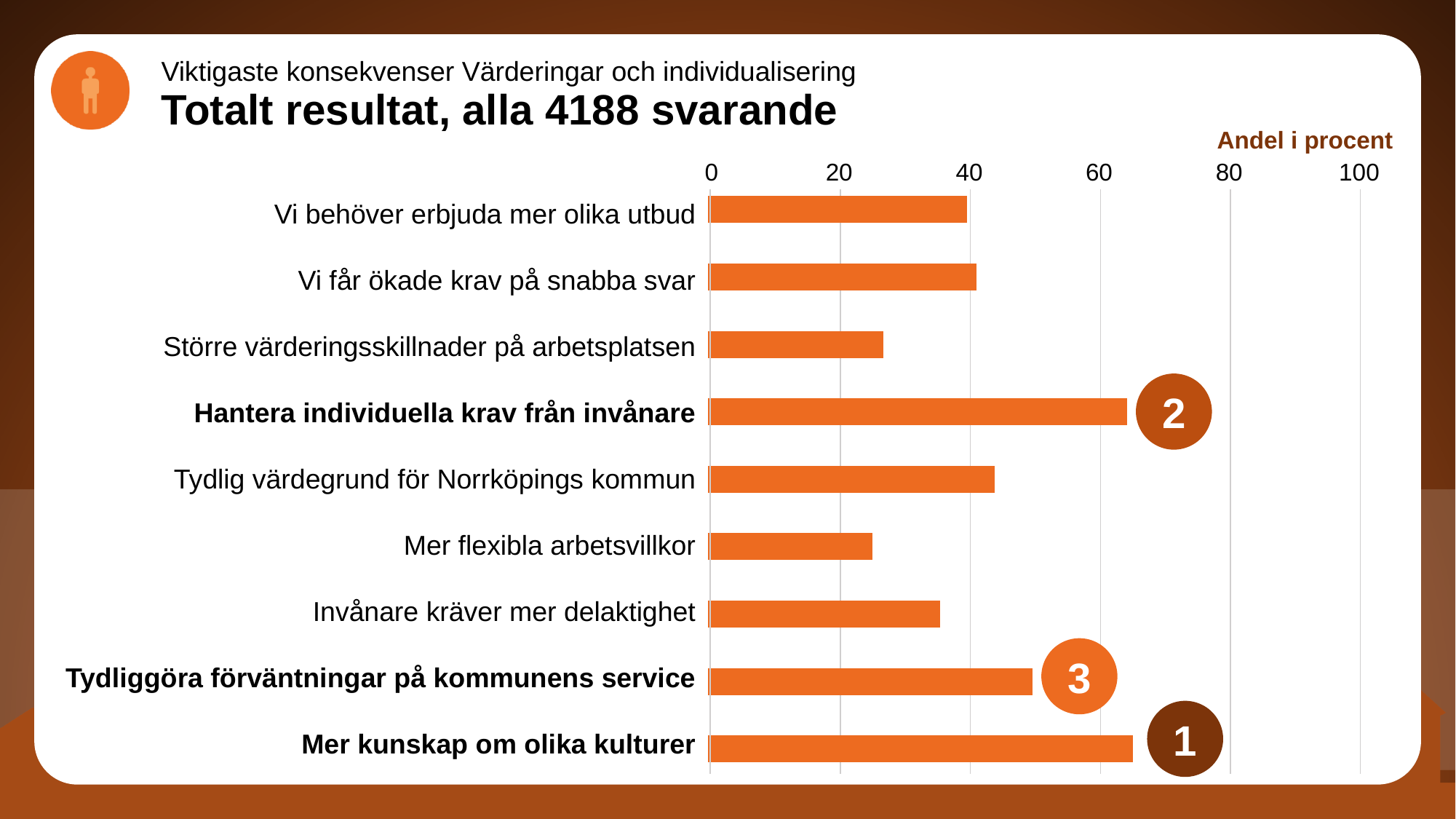
Which has the larger value: "Hantera individuella krav från invånare" or "Mer flexibla arbetsvillkor"? Hantera individuella krav från invånare Is the value for "Mer kunskap om olika kulturer" greater or less than 60? greater How many categories are plotted in the chart? 9 Is the value for "Hantera individuella krav från invånare" greater or less than 60? greater Which has the larger value: "Tydliggöra förväntningar på kommunens service" or "Invånare kräver mer delaktighet"? Tydliggöra förväntningar på kommunens service Is the value for "Invånare kräver mer delaktighet" greater or less than 40? less What label is shown above the horizontal axis of the chart? Andel i procent What kind of chart is shown on the slide? bar chart Which category is marked with the badge "1" on the chart? Mer kunskap om olika kulturer